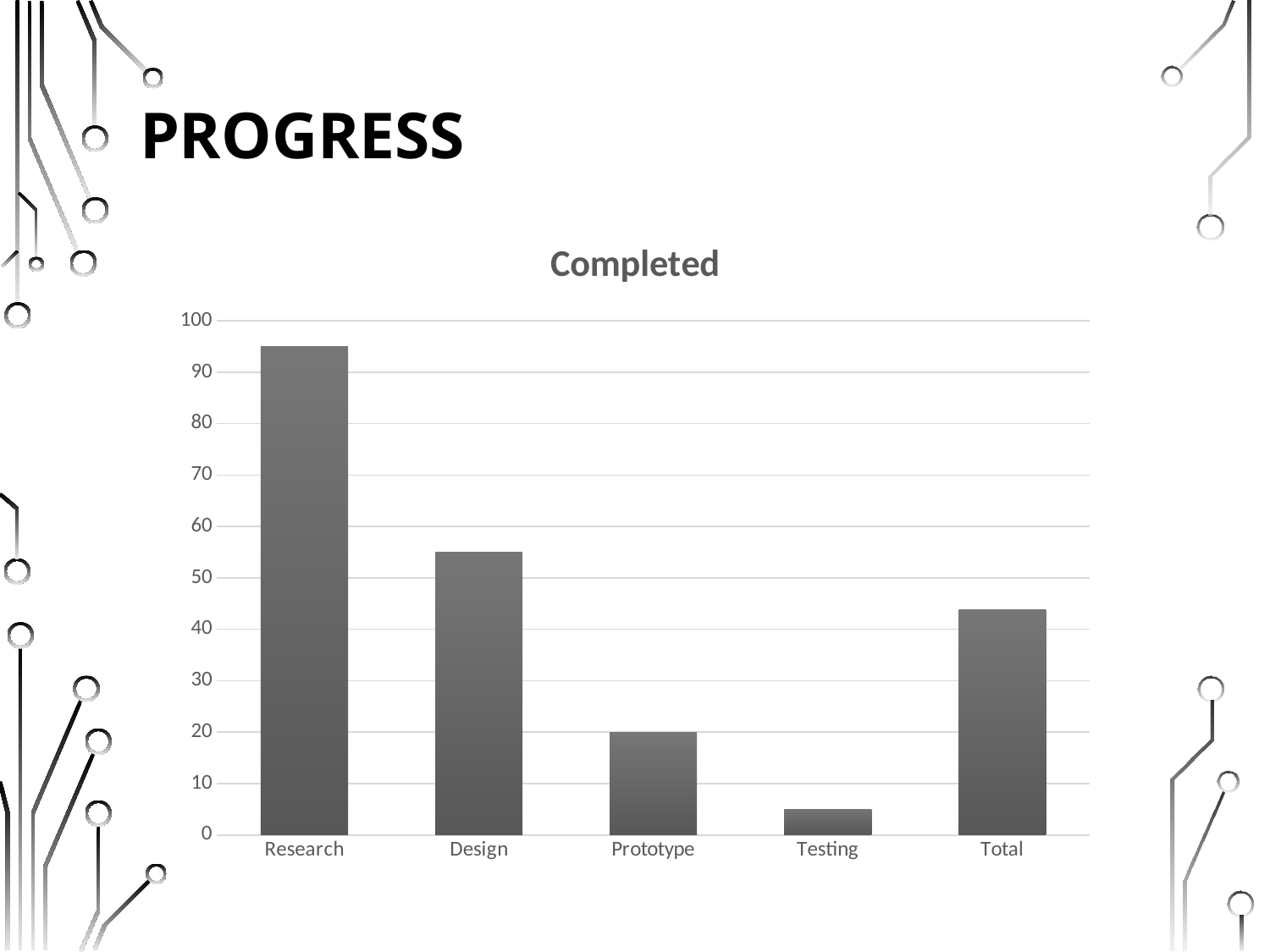
Is the value for Design greater or less than 50? greater Is the value for Research greater or less than 90? greater Is the value for Testing greater or less than 10? less What is the title of the chart? Completed Which is larger, the value for Prototype or the value for Testing? Prototype Which category has the lowest bar? Testing Which is larger, the value for Design or the value for Total? Design What kind of chart is shown on the slide? bar chart How many categories are shown on the x axis of the chart? 5 Which category has the highest bar? Research